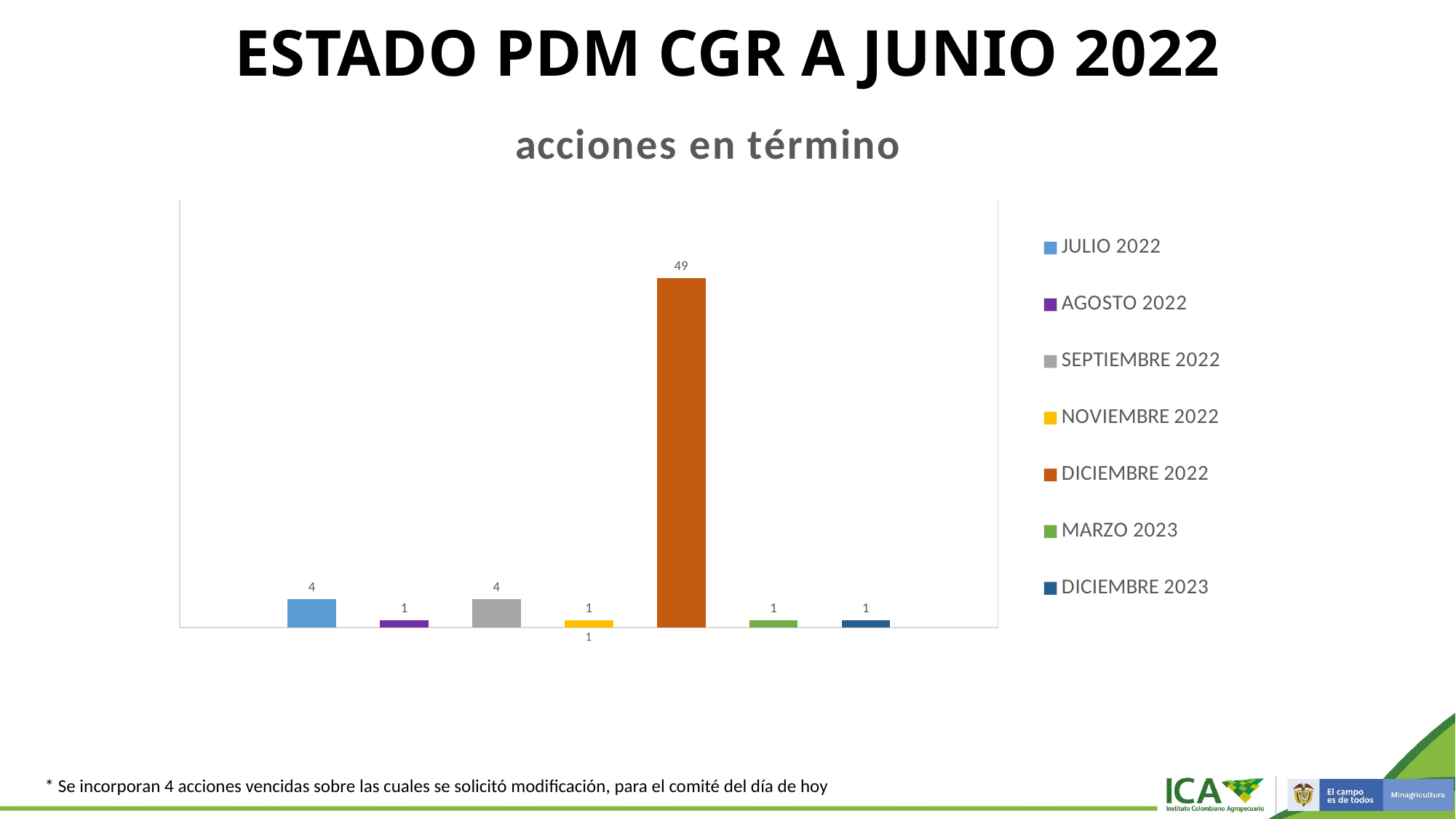
What kind of chart is shown on the slide? bar chart What is the difference between the values for SEPTIEMBRE 2022 and NOVIEMBRE 2022? 3 What is the value for DICIEMBRE 2022? 49 How many series does the legend list? 7 What is the title of the chart? acciones en término Which is larger, the value for JULIO 2022 or the value for AGOSTO 2022? JULIO 2022 What is the value for AGOSTO 2022? 1 Which series has the highest value? DICIEMBRE 2022 What is the value for MARZO 2023? 1 What is the value for SEPTIEMBRE 2022? 4 What is the difference between the values for DICIEMBRE 2022 and JULIO 2022? 45 What is the value for JULIO 2022? 4